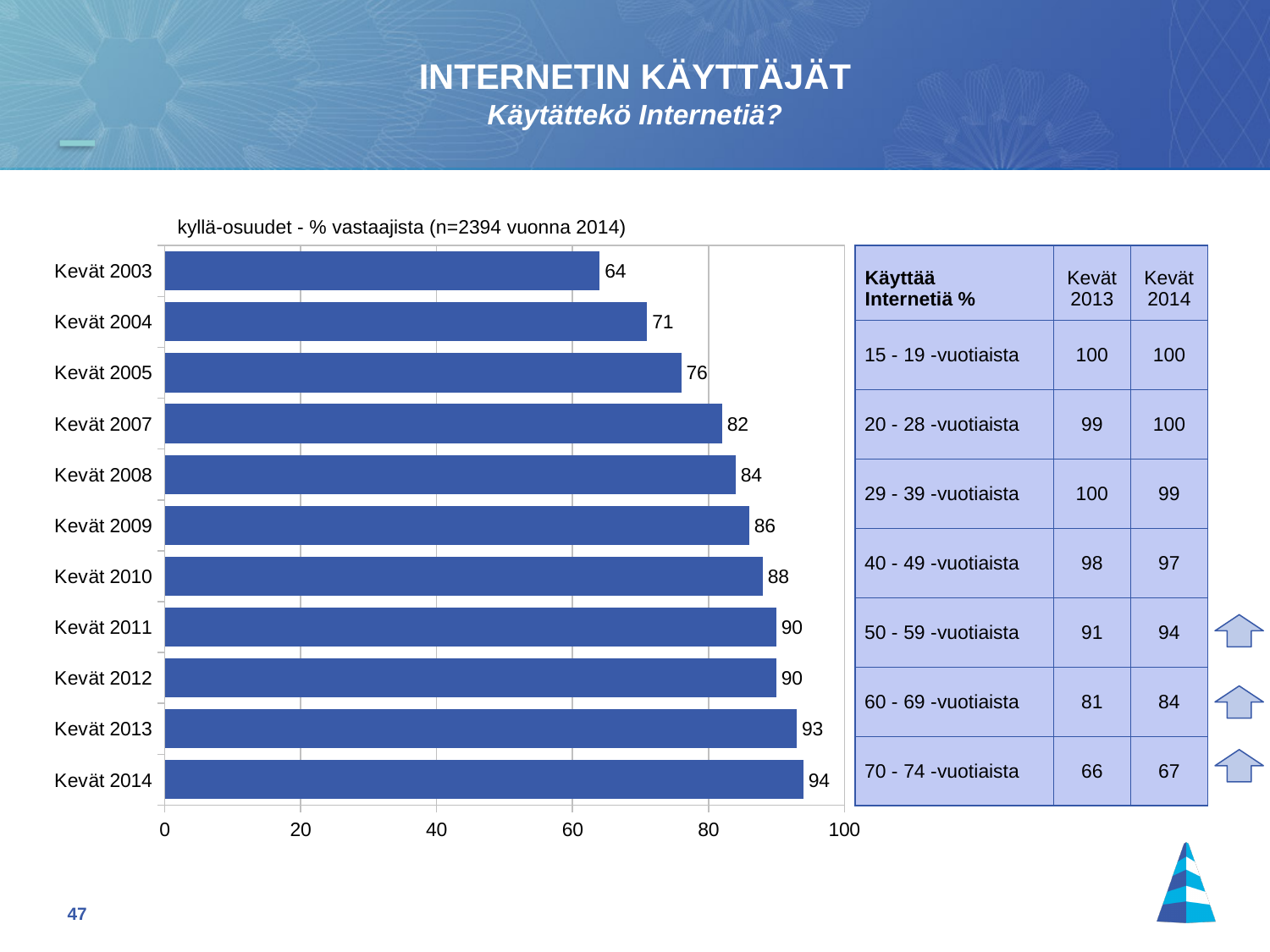
What kind of chart is shown on the slide? bar chart What is the title of the chart? kyllä-osuudet - % vastaajista (n=2394 vuonna 2014) Which category has the highest value? Kevät 2014 Is the value for Kevät 2005 greater or less than 80? less Which is larger, the value for Kevät 2007 or the value for Kevät 2010? Kevät 2010 What is the value for Kevät 2003? 64 Do the values rise or fall from Kevät 2003 to Kevät 2014? rise How many categories are shown in the chart? 11 What is the value for Kevät 2009? 86 What is the difference between the values for Kevät 2014 and Kevät 2003? 30 What is the value for Kevät 2014? 94 Which category has the lowest value? Kevät 2003